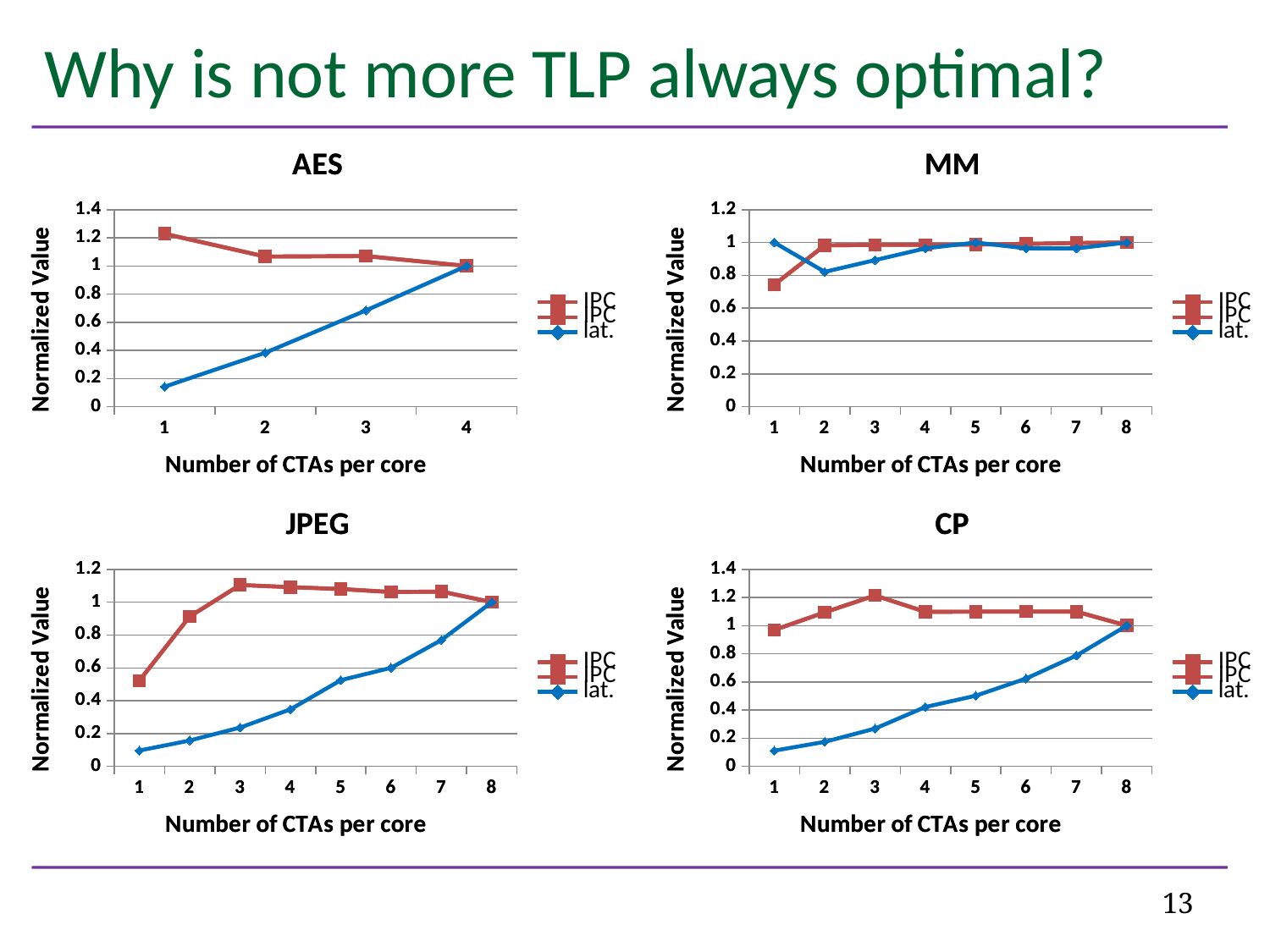
In the AES chart, does the blue line rise or fall as the number of CTAs per core increases? rises How many charts are shown on the slide? 4 In the MM chart, how many values of Number of CTAs per core are shown on the x axis? 8 In the MM chart, is the value of the red line at 1 CTA per core greater or less than 0.8? less In the AES chart, is the value of the blue line at 1 CTA per core greater or less than 0.2? less In the AES chart, does the red line rise or fall as the number of CTAs per core increases? falls In the CP chart, at which number of CTAs per core does the red line reach its highest value? 3 What kind of chart is the AES chart? line chart In the JPEG chart, at 1 CTA per core, which line has the larger value, the red line or the blue line? red line In the AES chart, how many points are plotted along the x axis for each line? 4 In the JPEG chart, at which number of CTAs per core is the blue line lowest? 1 In the JPEG chart, is the value of the red line at 1 CTA per core greater or less than 0.6? less